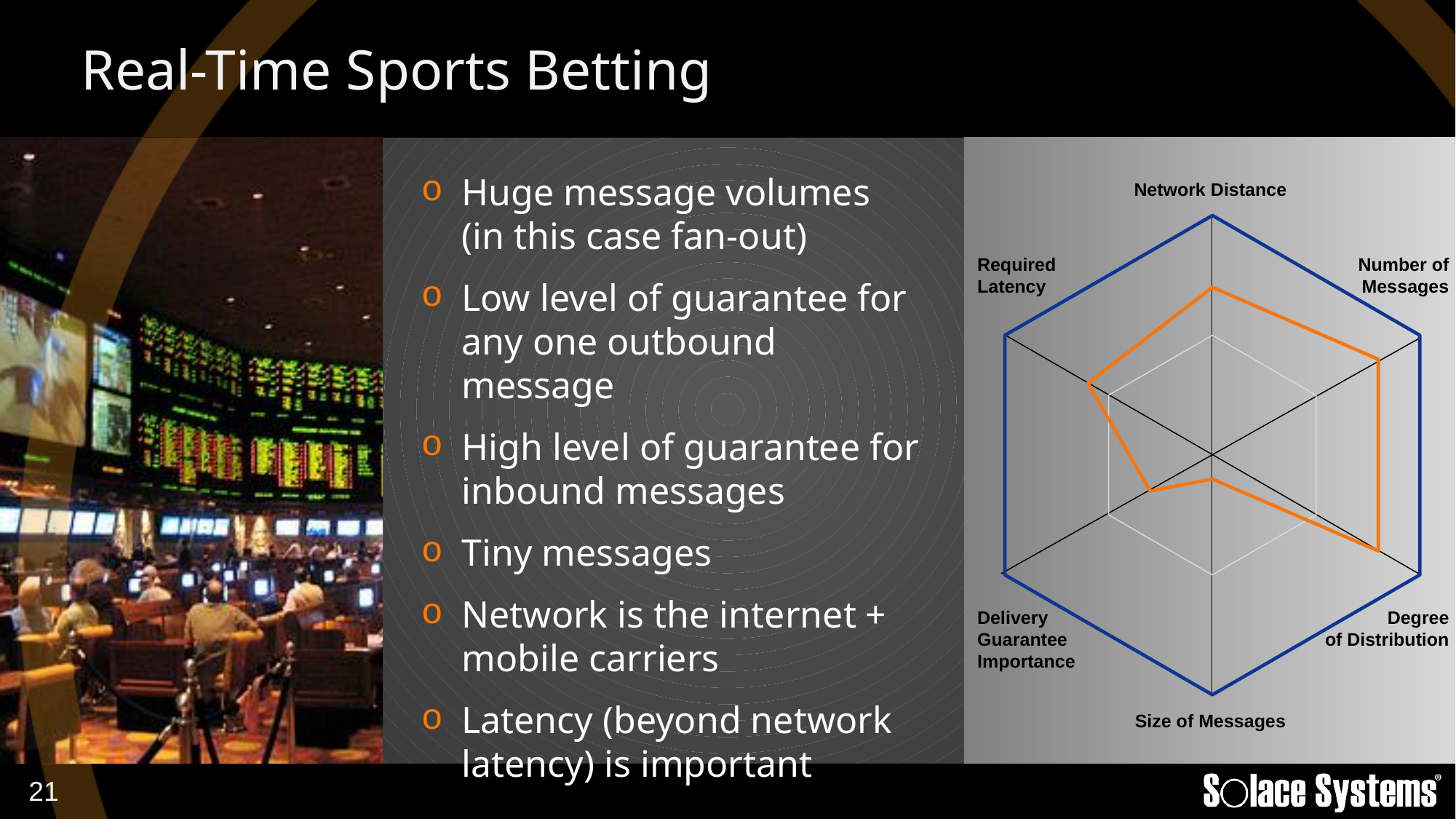
On the radar chart, which is larger: the value for Degree of Distribution or the value for Delivery Guarantee Importance? Degree of Distribution On the radar chart, which is larger: the value for Network Distance or the value for Size of Messages? Network Distance What kind of chart is shown on the right side of the slide? Radar chart How many axes (categories) does the radar chart have? 6 Which axis label appears at the top of the radar chart? Network Distance Which axis of the radar chart has the lowest value on the orange line? Size of Messages On the radar chart, which is larger: the value for Number of Messages or the value for Size of Messages? Number of Messages What colour is the data line plotted on the radar chart? Orange